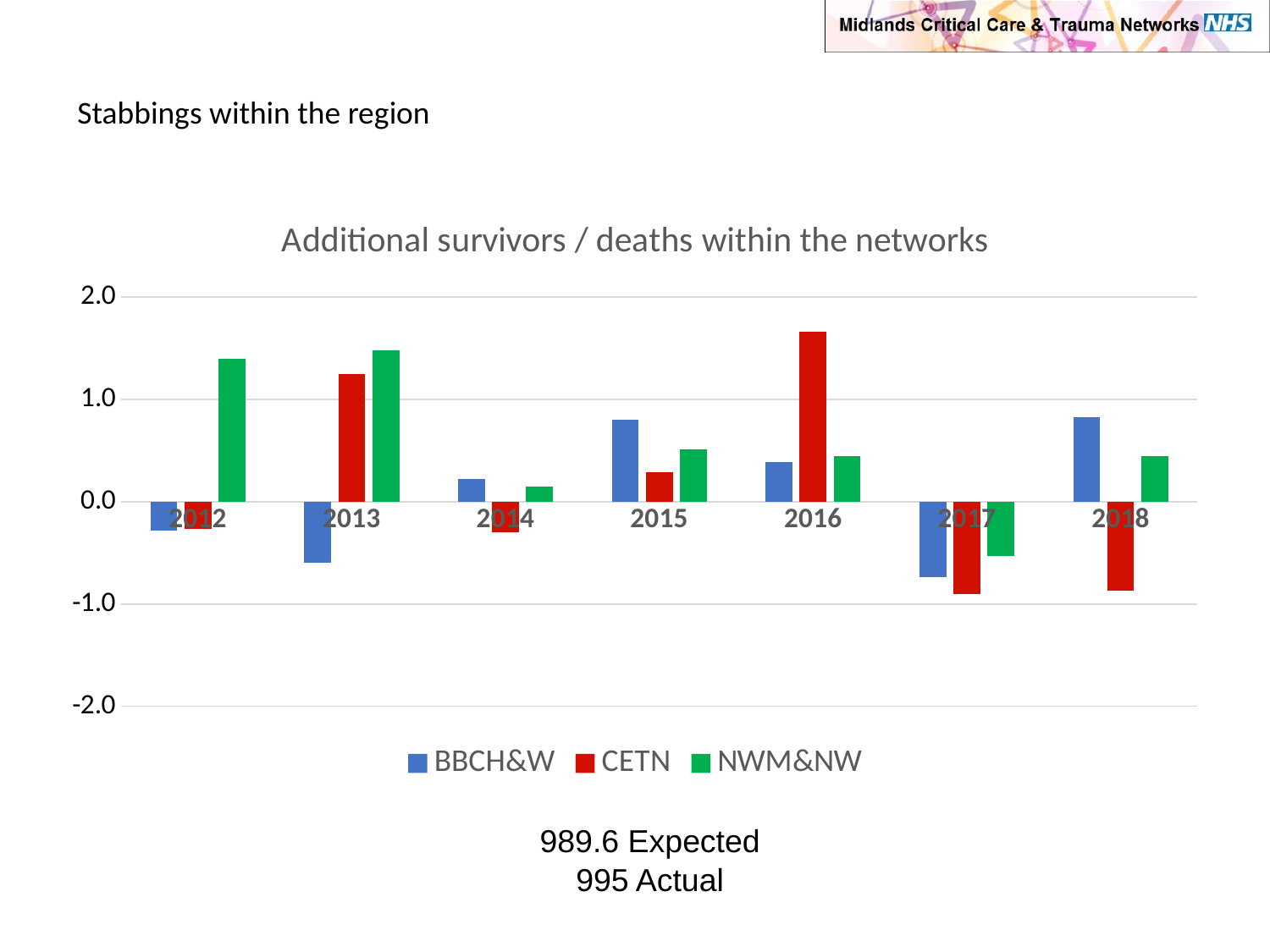
What kind of chart is shown on the slide? bar chart How many series does the legend list? 3 In which year is the BBCH&W value lowest? 2017 Is the value for CETN in 2017 greater or less than -1.0? greater How many years are shown on the x axis? 7 In which year is the CETN value highest? 2016 Is the value for CETN in 2016 greater or less than 1.0? greater Is the value for BBCH&W in 2015 greater or less than 1.0? less What is the title of the chart? Additional survivors / deaths within the networks In 2016, which series has the tallest bar? CETN In 2013, which is larger: the CETN value or the BBCH&W value? CETN